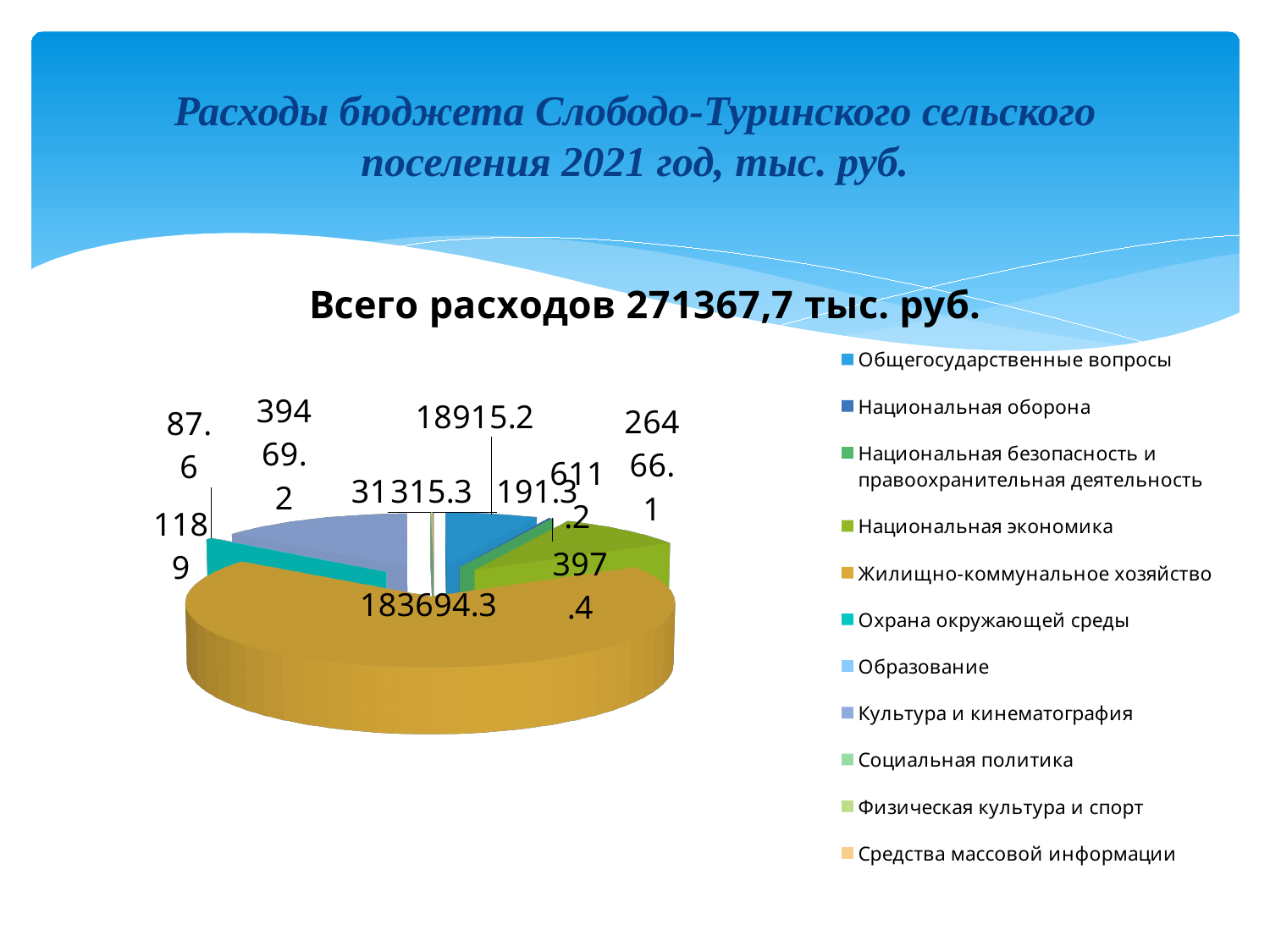
What is the value for Жилищно-коммунальное хозяйство? 183694.3 What is the difference between Жилищно-коммунальное хозяйство and Культура и кинематография? 144225.1 What total expenditure is stated in the chart title? 271367,7 тыс. руб. What is the title of the pie chart? Всего расходов 271367,7 тыс. руб. What is the value for Национальная экономика? 26466.1 How many categories does the legend of the pie chart list? 11 Which category has the largest slice of the pie? Жилищно-коммунальное хозяйство What is the value for Культура и кинематография? 39469.2 What is the value for Общегосударственные вопросы? 18915.2 Which is larger, Жилищно-коммунальное хозяйство or Культура и кинематография? Жилищно-коммунальное хозяйство Which is larger, Общегосударственные вопросы or Национальная экономика? Национальная экономика What kind of chart is shown on the slide? pie chart